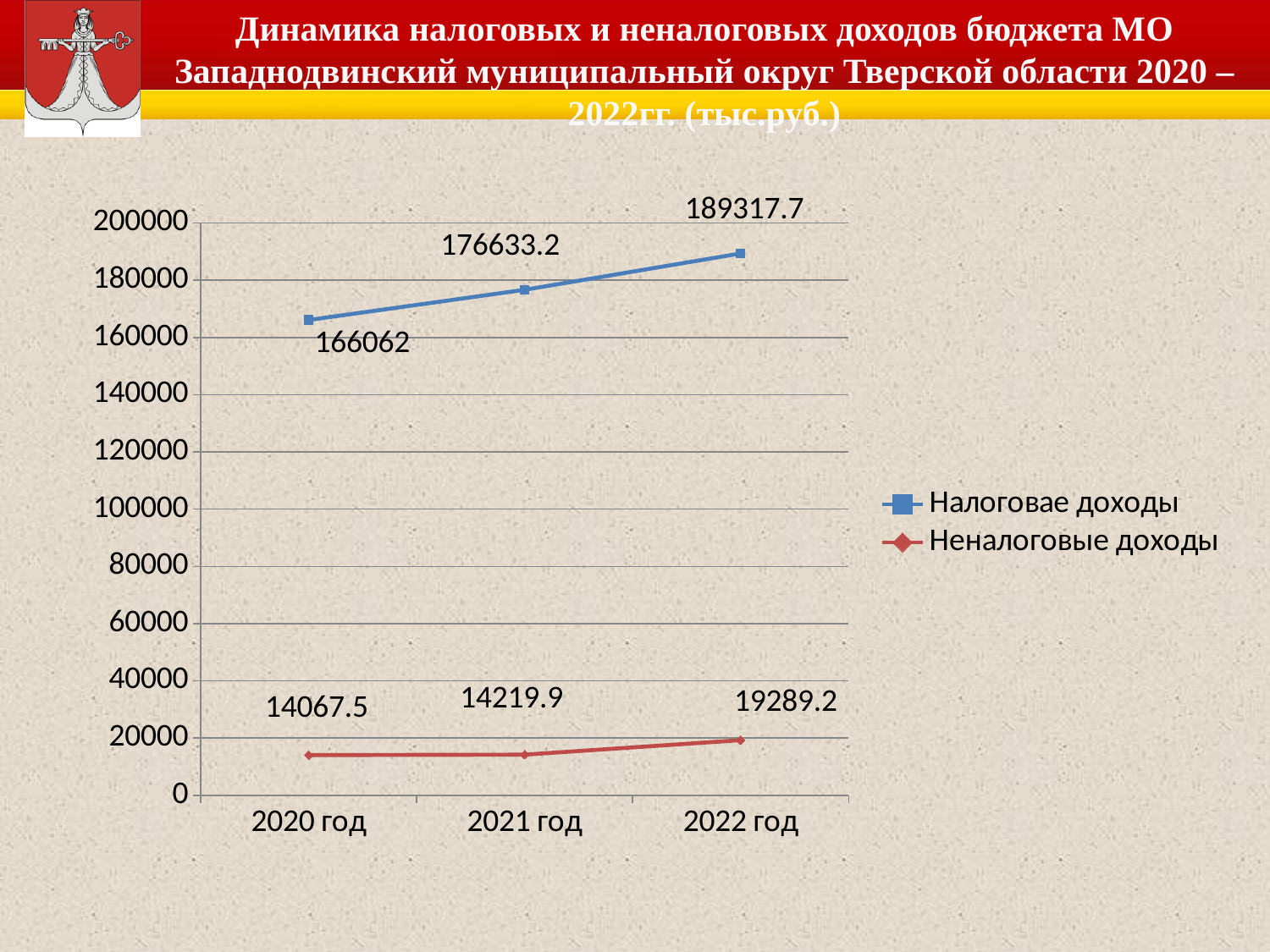
How many years are shown on the x axis? 3 Which is larger in 2021 год: Налоговае доходы or Неналоговые доходы? Налоговае доходы What is the difference between Неналоговые доходы in 2022 год and 2020 год? 5221.7 What is the difference between Налоговае доходы in 2022 год and 2020 год? 23255.7 Is the value of Налоговае доходы for 2022 год greater or less than 180000? greater What is the value of Неналоговые доходы for 2022 год? 19289.2 In which year is Неналоговые доходы highest? 2022 год How many series does the legend list? 2 What is the value of Налоговае доходы for 2020 год? 166062 What kind of chart is shown on the slide? line chart In which year is Налоговае доходы lowest? 2020 год What is the value of Налоговае доходы for 2021 год? 176633.2